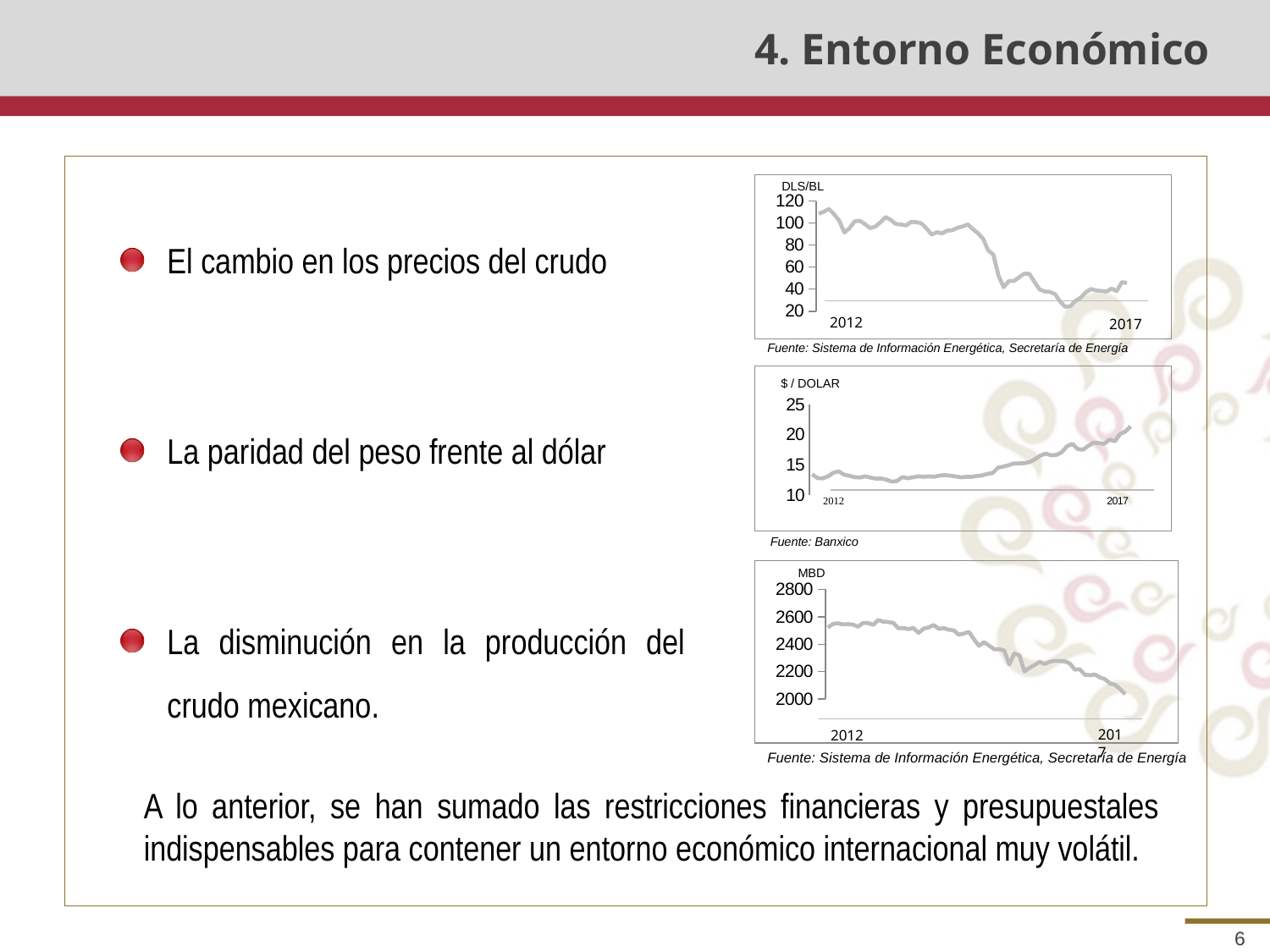
What source is cited below the middle chart ($ / DOLAR)? Banxico What kind of chart is the middle chart labelled $ / DOLAR? line chart In the top chart (DLS/BL), is the value at the start of 2012 greater or less than 80? greater What kind of chart is the bottom chart labelled MBD? line chart In the top chart (DLS/BL), is the value at the end of the series in 2017 greater or less than 80? less In the middle chart ($ / DOLAR), is the value in 2012 greater or less than 15? less In the top chart (DLS/BL), do the values overall rise or fall from 2012 to 2017? fall In the bottom chart (MBD), do the values overall rise or fall from 2012 to 2017? fall In the middle chart ($ / DOLAR), do the values overall rise or fall from 2012 to 2017? rise What kind of chart is the top chart labelled DLS/BL? line chart